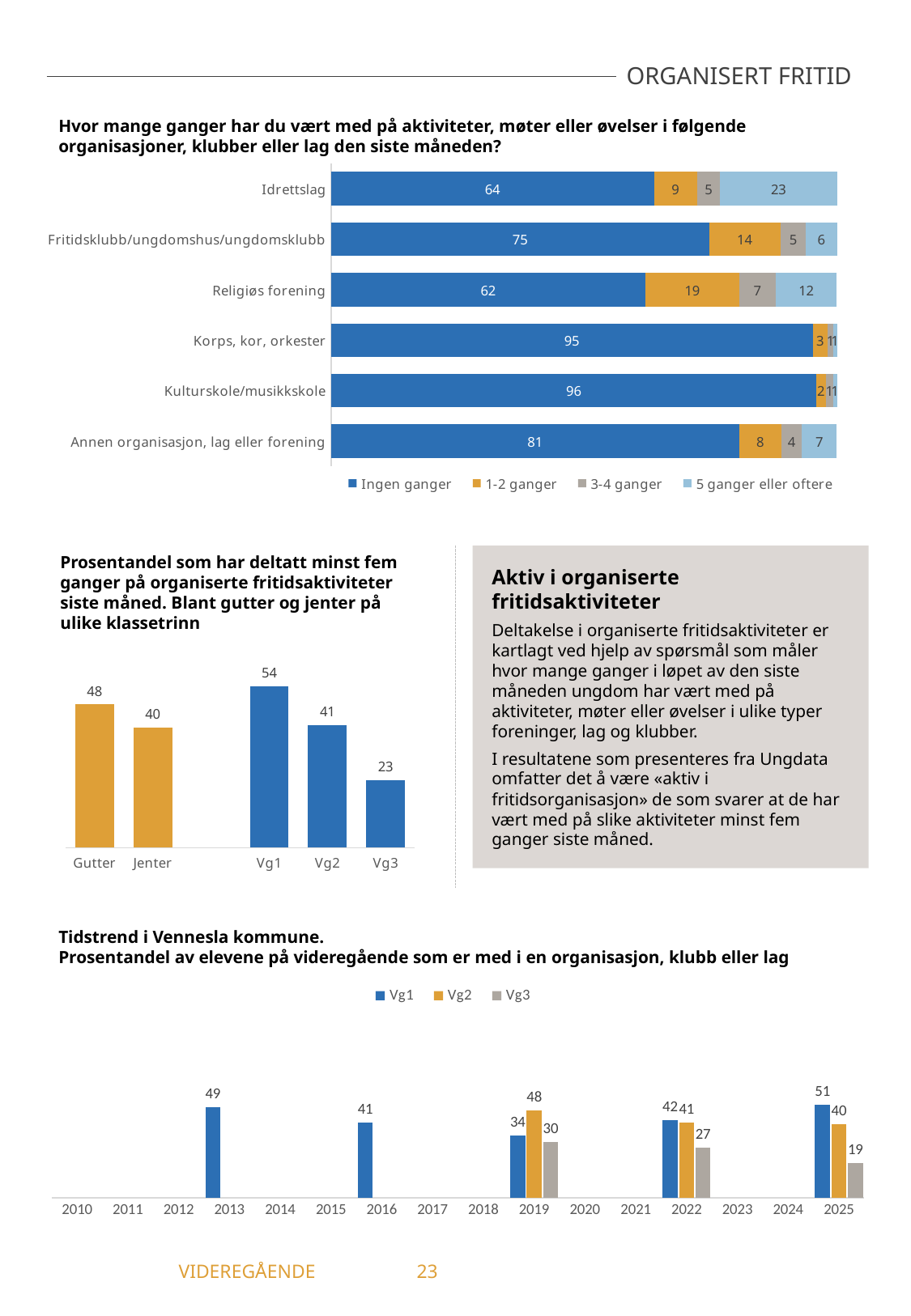
In the bottom chart, what kind of chart is shown? Bar chart In the bottom chart, which is larger in 2025: Vg1 or Vg3? Vg1 In the top chart (Hvor mange ganger har du vært med på aktiviteter...), what is the value for 'Ingen ganger' for Idrettslag? 64 In the top chart, what is the value for '5 ganger eller oftere' for Religiøs forening? 12 In the middle-left chart (Prosentandel som har deltatt minst fem ganger...), what is the value for Vg1? 54 In the top chart, what is the difference between the '1-2 ganger' values for Religiøs forening and Idrettslag? 10 In the top chart, how many series does the legend list? 4 In the middle-left chart, which category has the lowest value? Vg3 In the top chart, how many categories are shown? 6 In the top chart, which category has the highest value for 'Ingen ganger'? Kulturskole/musikkskole In the bottom chart (Tidstrend i Vennesla kommune), what is the Vg2 value for 2019? 48 In the middle-left chart, what is the difference between Gutter and Jenter? 8